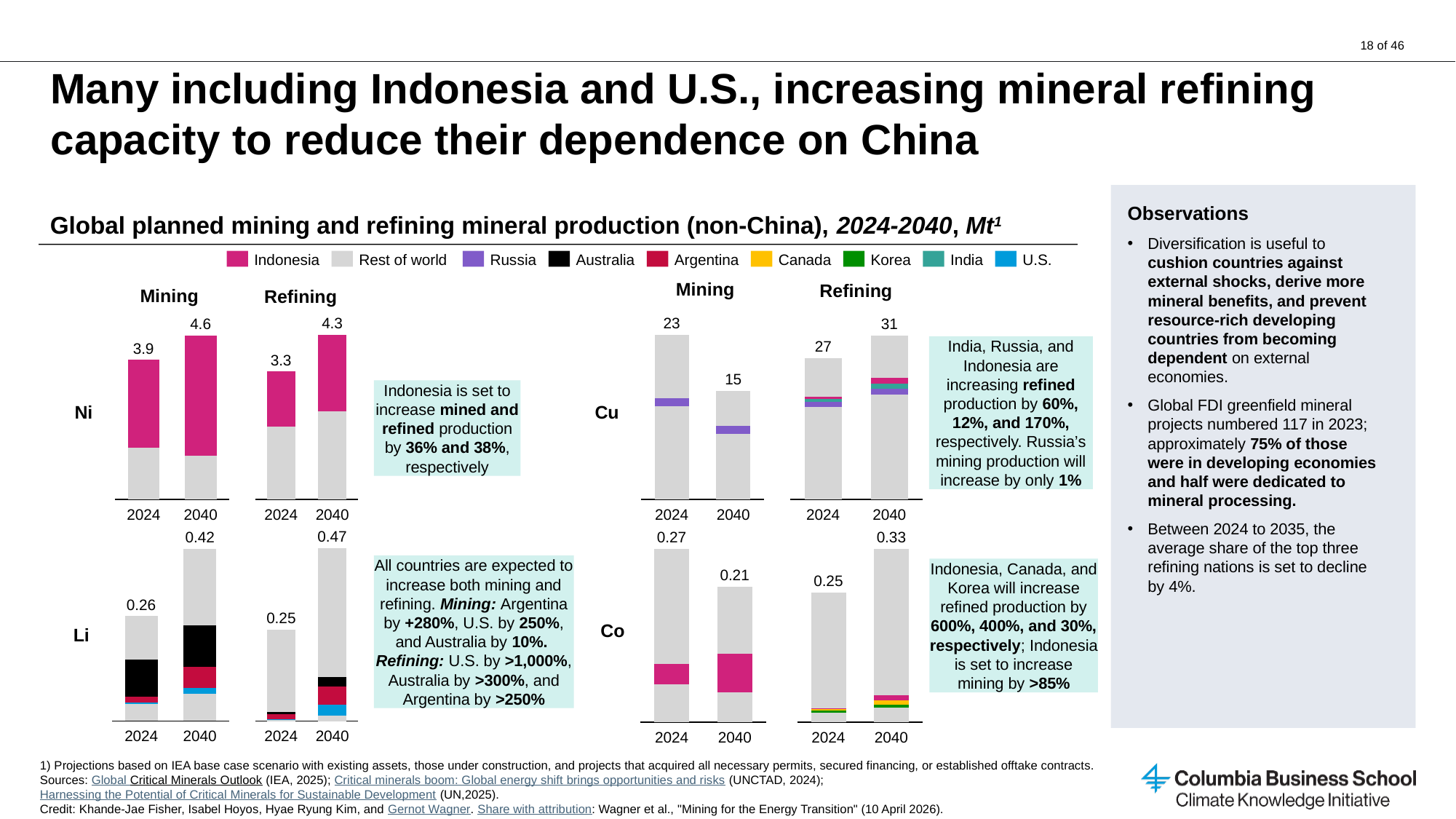
In the Co Mining chart, which year has the higher total, 2024 or 2040? 2024 In the Co Refining chart, what is the difference between the 2040 and 2024 totals? 0.08 In the Ni Refining chart, what is the total value shown for 2024? 3.3 What type of chart is used for the Ni Mining panel? stacked bar chart In the Cu Mining chart, does the total rise or fall from 2024 to 2040? fall In the Cu Mining chart, what is the total value for 2040? 15 How many series does the shared legend list? 9 In the Li Refining chart, what is the total value for 2040? 0.47 In the Cu Refining chart, by how much does the 2040 total exceed the 2024 total? 4 In the Li Mining chart, does the total rise or fall from 2024 to 2040? rise In the Ni Mining chart, what is the total planned production for 2040? 4.6 Which colour represents Indonesia in the legend? magenta/pink